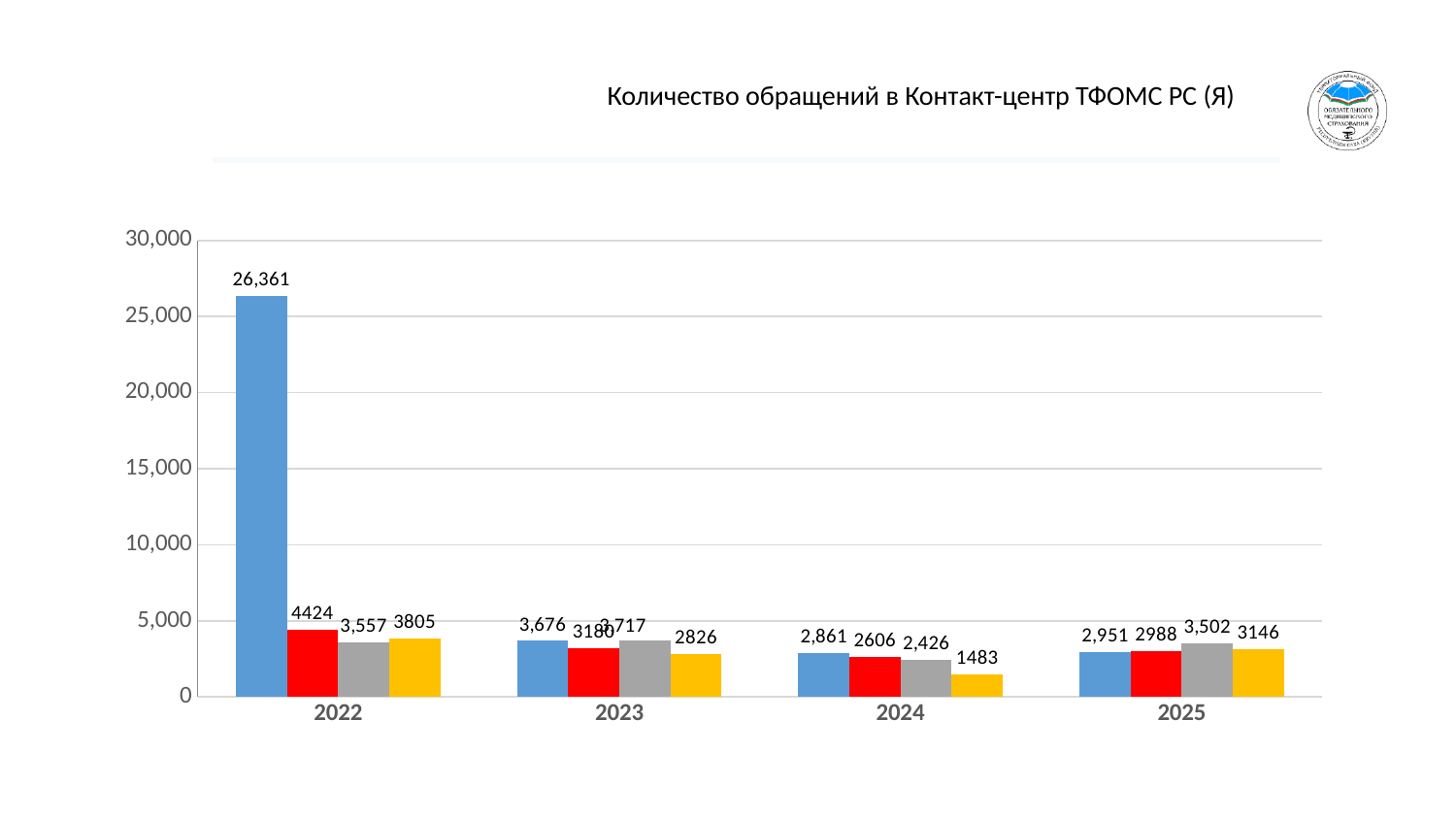
What is the value of the red bar for 2023? 3180 Which year has the lowest yellow bar? 2024 Which is larger for 2024, the blue bar or the red bar? the blue bar What is the difference between the red bar and the grey bar for 2022? 867 How many years are shown on the x axis? 4 What is the title of the chart? Количество обращений в Контакт-центр ТФОМС РС (Я) What is the value of the grey bar for 2025? 3,502 Which year has the highest blue bar? 2022 Is the value of the blue bar for 2022 greater or less than 25,000? greater What kind of chart is shown on the slide? bar chart What is the value of the blue bar for 2022? 26,361 What is the value of the yellow bar for 2024? 1483